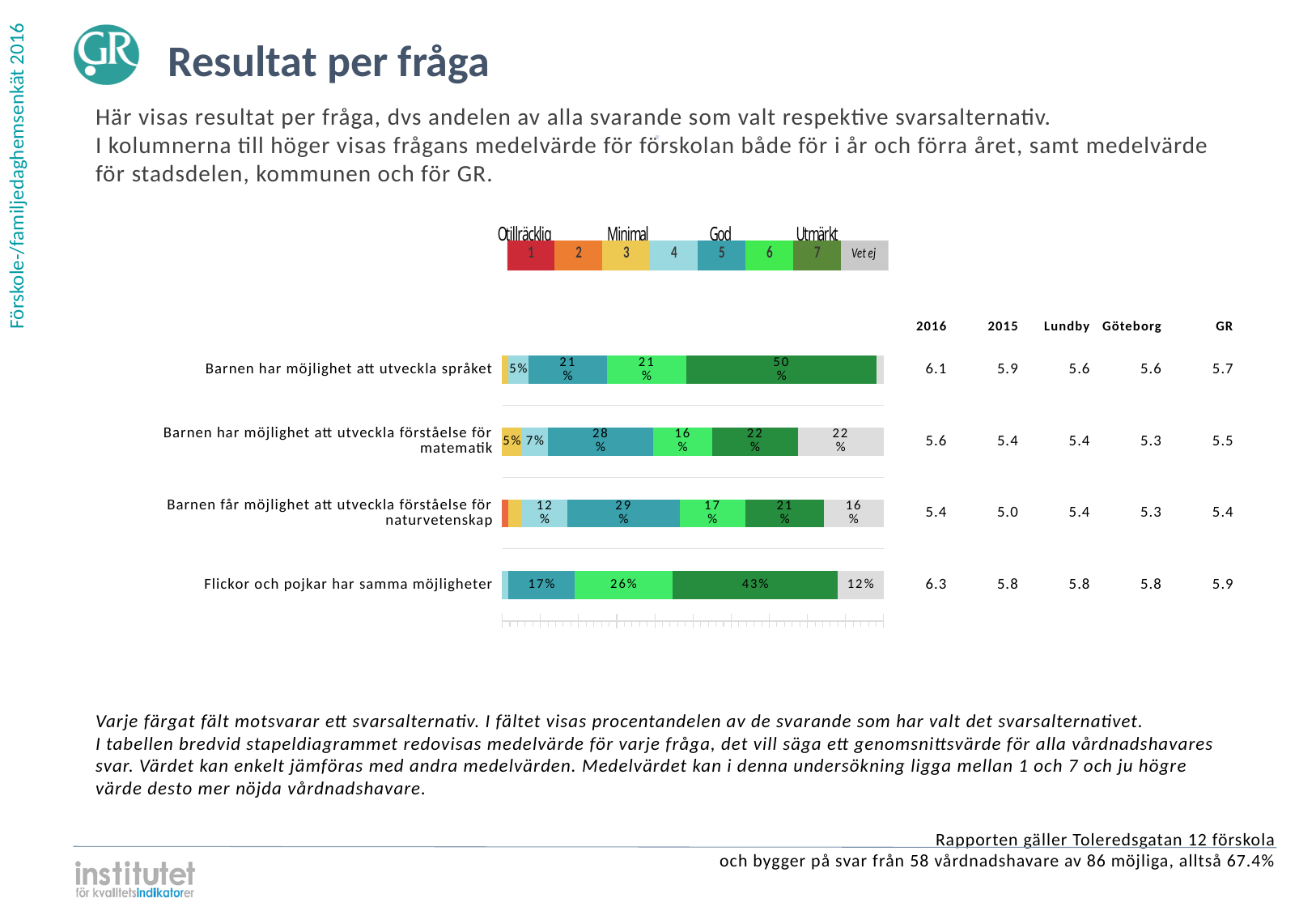
Which question has the smallest share of respondents choosing 7 (Utmärkt)? Barnen får möjlighet att utveckla förståelse för naturvetenskap Which has a larger 'Vet ej' share: 'Barnen har möjlighet att utveckla förståelse för matematik' or 'Flickor och pojkar har samma möjligheter'? Barnen har möjlighet att utveckla förståelse för matematik What percentage of respondents chose 6 for 'Flickor och pojkar har samma möjligheter'? 26% What is the difference between the share choosing 7 for 'Flickor och pojkar har samma möjligheter' and the share choosing 7 for 'Barnen har möjlighet att utveckla förståelse för matematik'? 21 percentage points What percentage of respondents chose 7 (Utmärkt) for 'Barnen har möjlighet att utveckla språket'? 50% What is the 2016 mean value shown for 'Flickor och pojkar har samma möjligheter'? 6.3 What percentage of respondents chose 5 for 'Barnen får möjlighet att utveckla förståelse för naturvetenskap'? 29% How many questions (categories) are plotted in the bar chart? 4 Which question has the largest share of respondents choosing 7 (Utmärkt)? Barnen har möjlighet att utveckla språket How many response options does the legend above the chart list? 8 What type of chart is shown on the slide? Stacked bar chart What percentage of respondents answered 'Vet ej' for 'Barnen har möjlighet att utveckla förståelse för matematik'? 22%